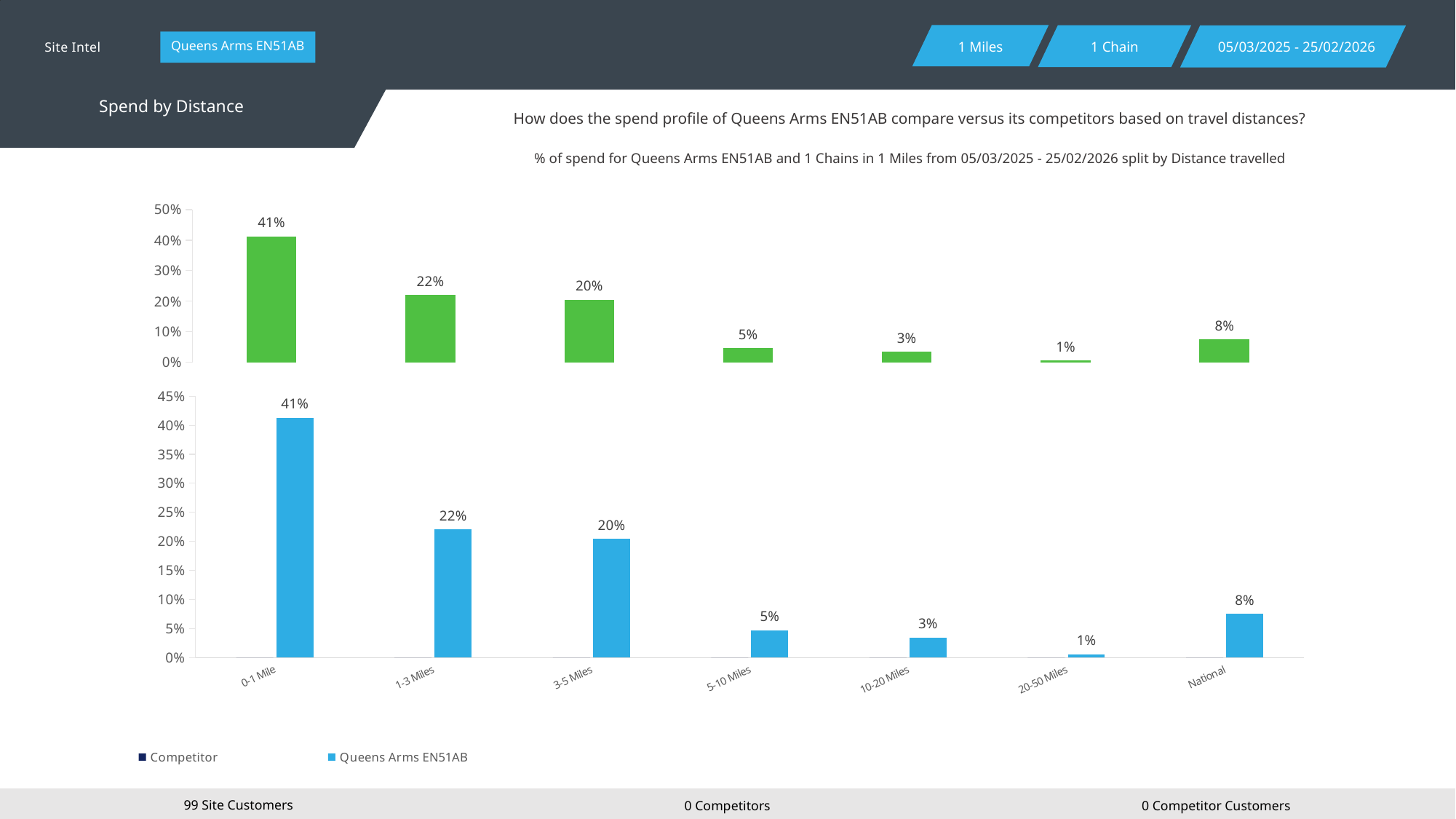
How many distance bands are shown on the x axis of the bottom chart? 7 In the bottom chart, what is the value for 0-1 Mile? 41% How many series does the legend list? 2 What kind of chart is the bottom chart? bar chart In the top chart, what is the value of the first bar on the left? 41% In the bottom chart, which distance band has the highest value? 0-1 Mile In the bottom chart, is the value for 3-5 Miles greater or less than 25%? less In the bottom chart, what is the value for National? 8% In the bottom chart, which distance band has the lowest value? 20-50 Miles In the bottom chart, which is larger, the value for 5-10 Miles or the value for National? National In the bottom chart, what is the value for 1-3 Miles? 22% In the bottom chart, what is the difference between the values for 0-1 Mile and 1-3 Miles? 19%